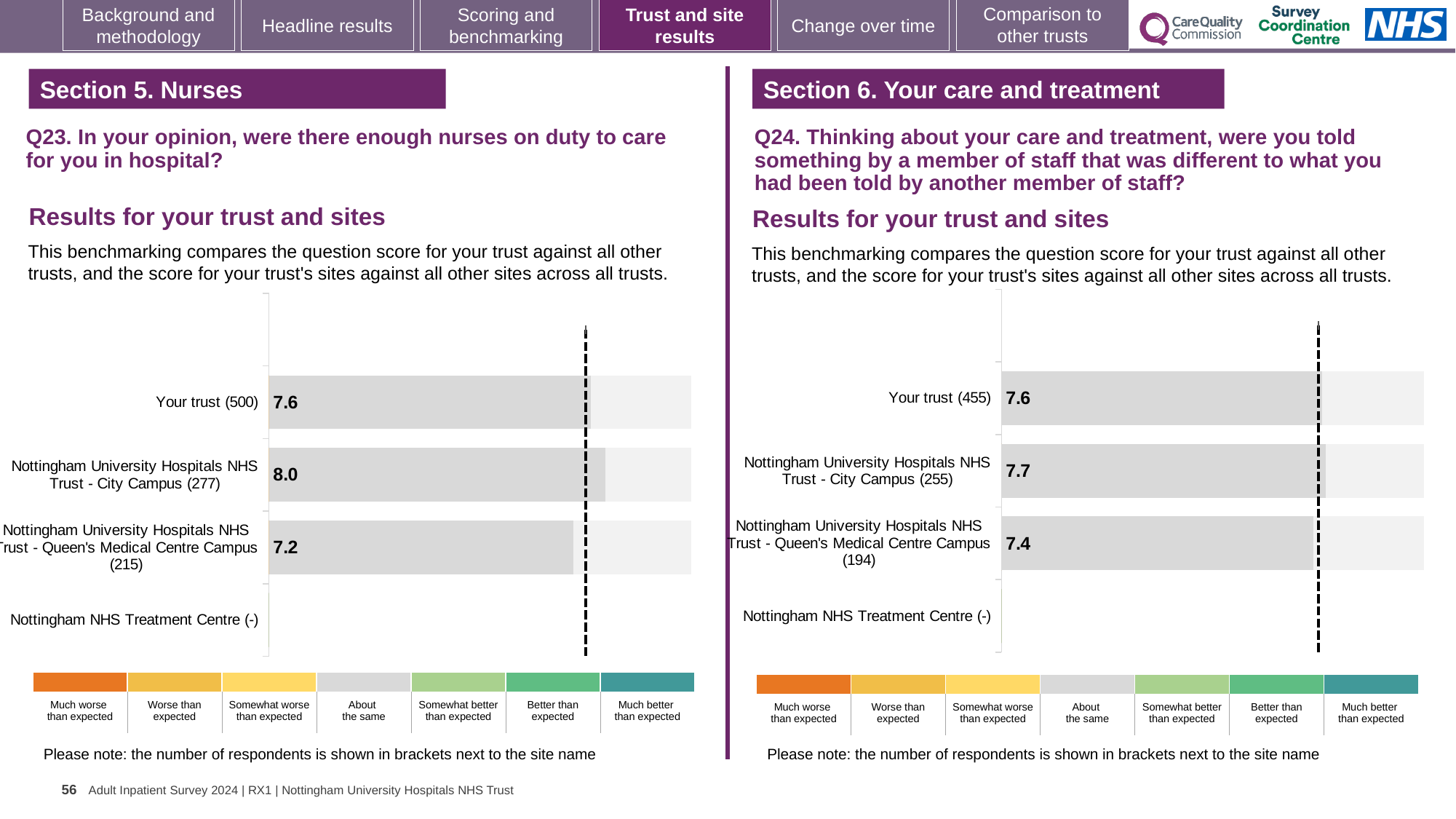
On the Q24 chart (right), which site shows no score (marked with a dash)? Nottingham NHS Treatment Centre (-) On the Q24 chart (right), which row has the highest score? Nottingham University Hospitals NHS Trust - City Campus (255) How many rows (categories) are listed on the Q23 chart (left)? 4 On the Q23 chart (left), what is the score for Nottingham University Hospitals NHS Trust - City Campus (277)? 8.0 On the Q23 chart (left), how many respondents are shown for Your trust? 500 On the Q24 chart (right), which is larger: the score for Your trust (455) or the score for Queen's Medical Centre Campus (194)? Your trust (455) On the Q23 chart (left), what is the difference between the City Campus score and the Queen's Medical Centre Campus score? 0.8 On the Q23 chart (left), what is the score for Your trust (500)? 7.6 On the Q23 chart (left), which site has the lowest score? Nottingham University Hospitals NHS Trust - Queen's Medical Centre Campus (215) On the Q24 chart (right), what is the difference between the City Campus score and the Your trust score? 0.1 What type of chart is used on the Q24 chart (right)? Bar chart On the Q24 chart (right), what is the score for Nottingham University Hospitals NHS Trust - Queen's Medical Centre Campus (194)? 7.4